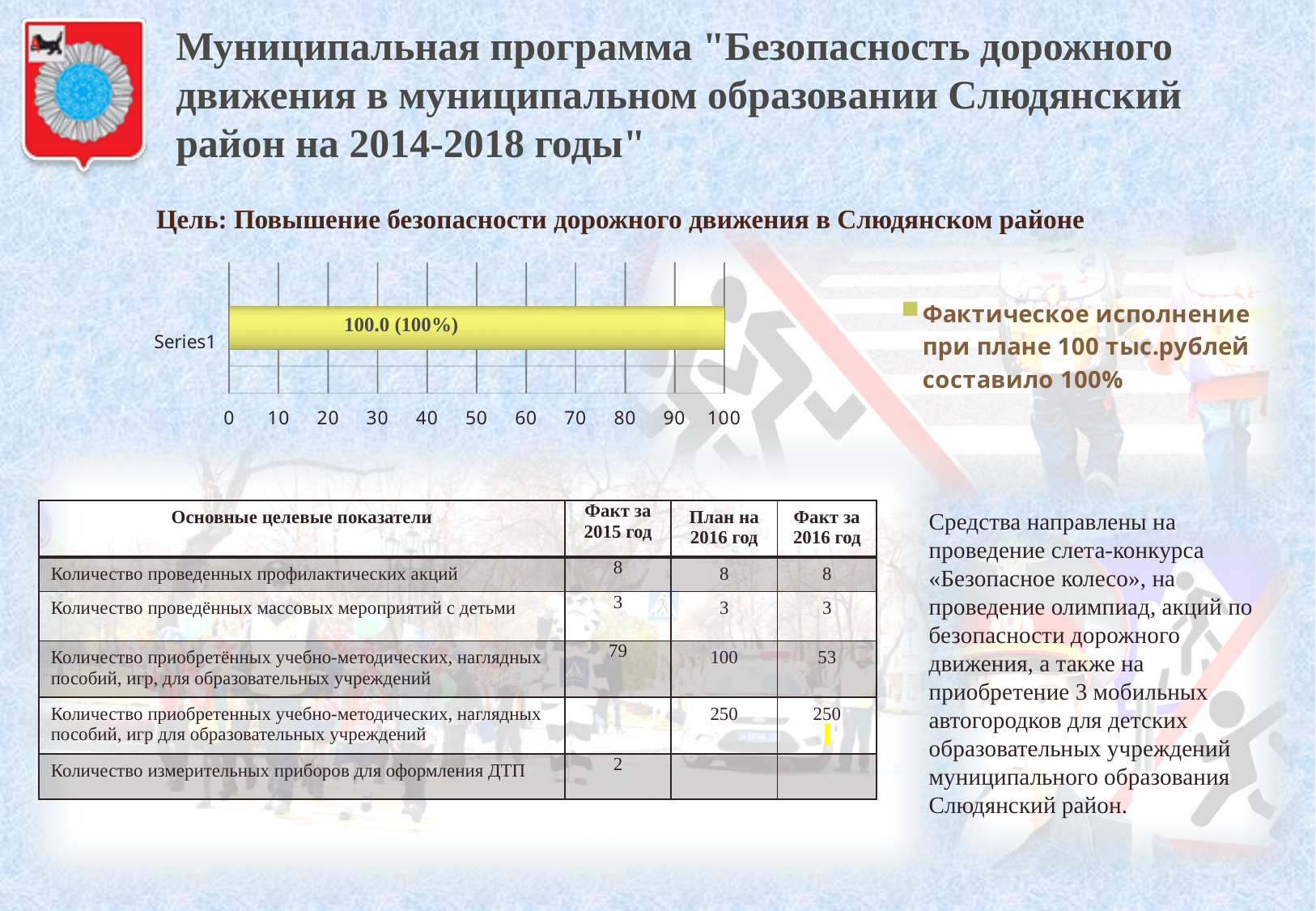
What is the label of the single category on the chart's vertical axis? Series1 What value is printed on the bar for Series1 in the chart? 100.0 (100%) What is the highest tick value shown on the chart's horizontal axis? 100 Is the value for Series1 greater or less than 50? greater What kind of chart is shown on the slide? bar chart How many bars does the chart contain? 1 Is the value for Series1 greater or less than 90? greater